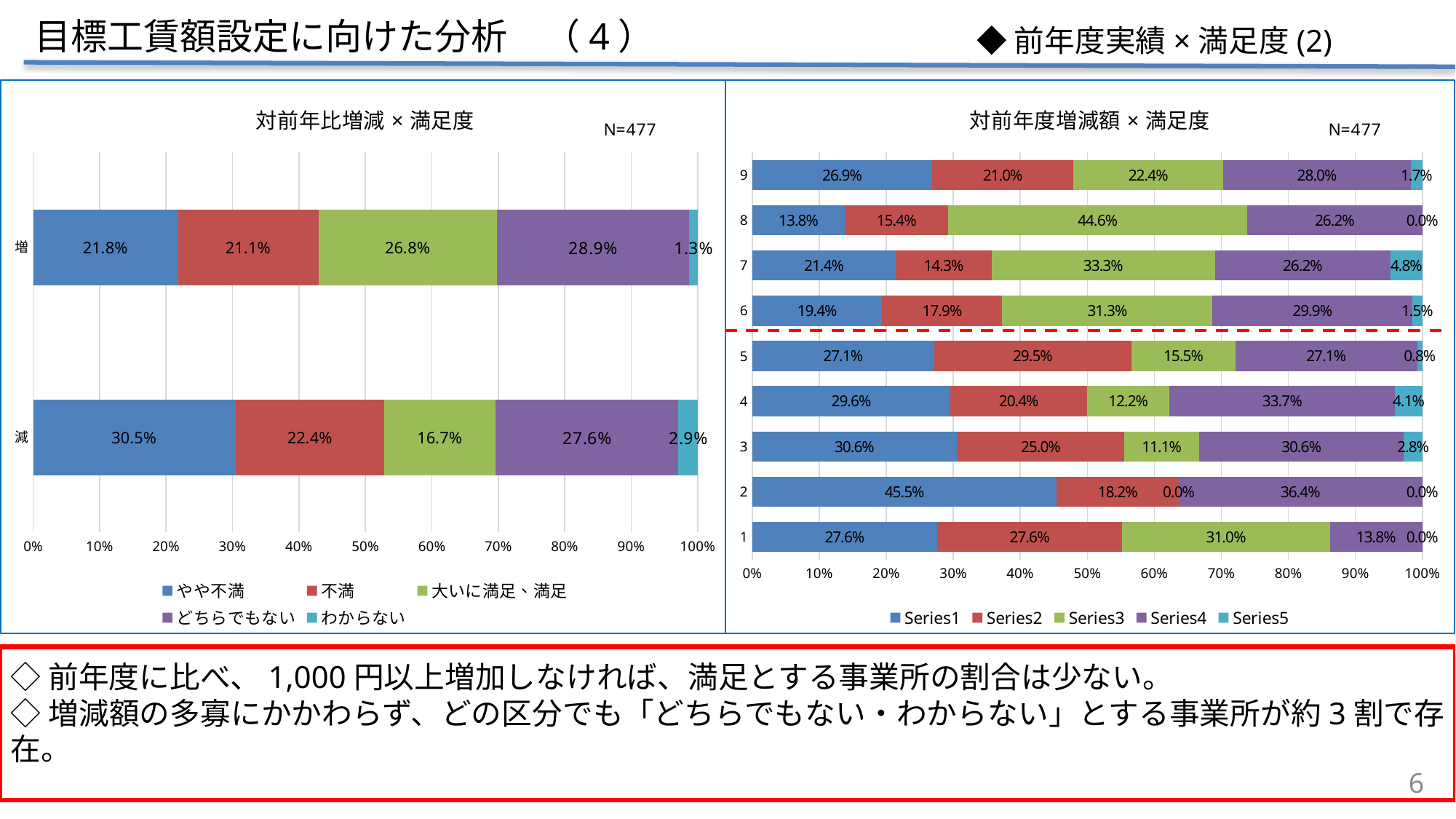
In the right chart titled 対前年度増減額 × 満足度, how many categories are shown on the vertical axis? 9 What sample size (N) is shown for the right chart titled 対前年度増減額 × 満足度? N=477 In the right chart titled 対前年度増減額 × 満足度, which category has the highest Series1 value? 2 In the left chart titled 対前年比増減 × 満足度, how many series does the legend list? 5 In the right chart titled 対前年度増減額 × 満足度, what is the Series1 value for category 2? 45.5% What kind of chart is the left chart titled 対前年比増減 × 満足度? Stacked bar chart In the right chart titled 対前年度増減額 × 満足度, which category has the highest Series3 value? 8 In the right chart titled 対前年度増減額 × 満足度, what is the Series3 value for category 8? 44.6% In the left chart titled 対前年比増減 × 満足度, what is the difference between the 大いに満足、満足 values for 増 and 減? 10.1% In the left chart titled 対前年比増減 × 満足度, which category has the larger わからない value, 増 or 減? 減 In the left chart titled 対前年比増減 × 満足度, what is the value of やや不満 for 減? 30.5% In the left chart titled 対前年比増減 × 満足度, what is the value of 大いに満足、満足 for 増? 26.8%